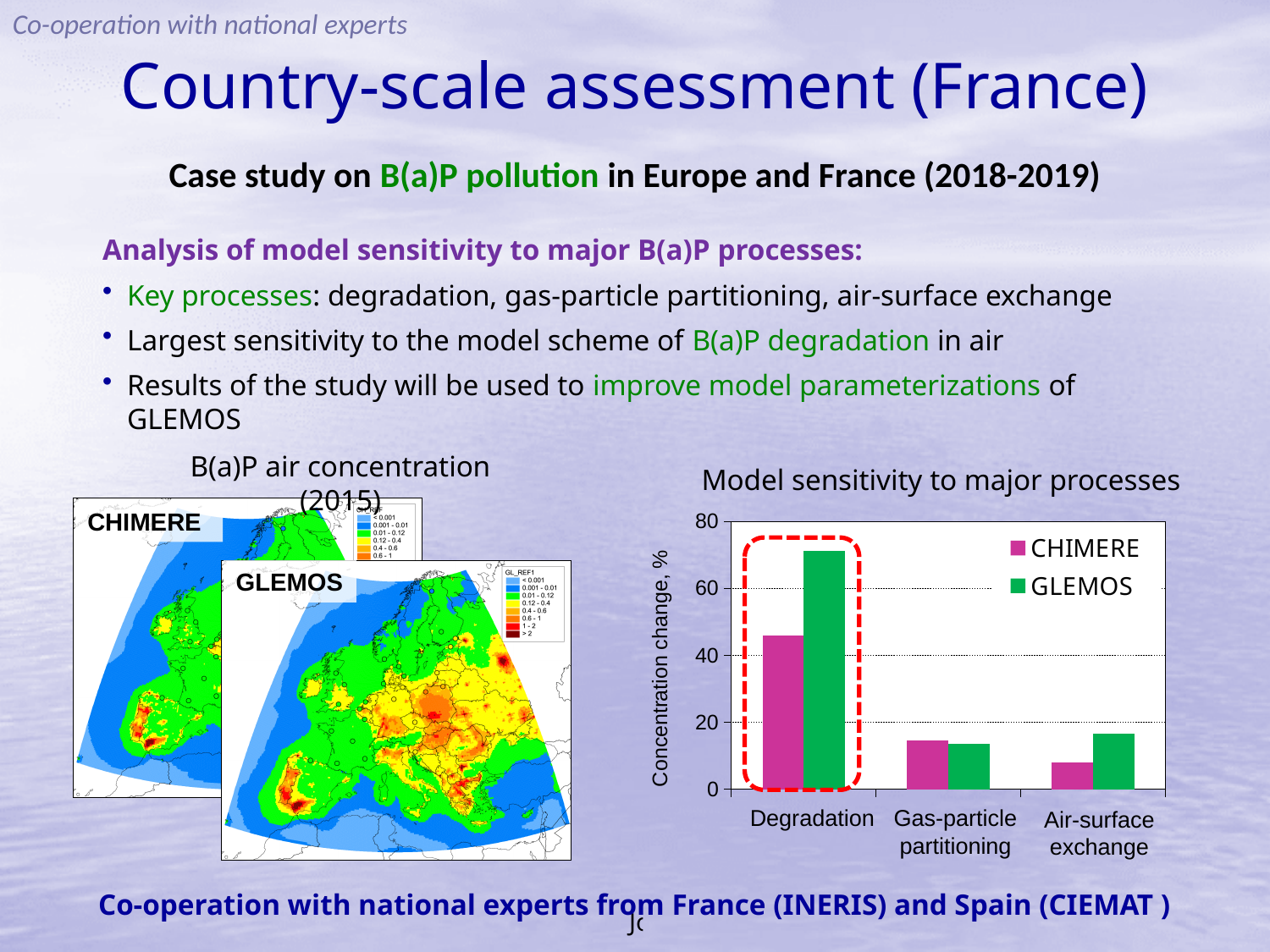
In the 'Model sensitivity to major processes' chart, which process has the highest CHIMERE value? Degradation How many process categories are shown on the x axis of the 'Model sensitivity to major processes' chart? 3 How many series does the legend of the 'Model sensitivity to major processes' chart list? 2 What kind of chart is 'Model sensitivity to major processes'? bar chart In the 'Model sensitivity to major processes' chart, which series has the larger value for Degradation, CHIMERE or GLEMOS? GLEMOS In the 'Model sensitivity to major processes' chart, which series has the larger value for Air-surface exchange, CHIMERE or GLEMOS? GLEMOS In the 'Model sensitivity to major processes' chart, is the GLEMOS value for Degradation greater or less than 60? greater In the 'Model sensitivity to major processes' chart, which process has the highest GLEMOS value? Degradation In the 'Model sensitivity to major processes' chart, is the CHIMERE value for Air-surface exchange greater or less than 20? less In the 'Model sensitivity to major processes' chart, is the CHIMERE value for Degradation greater or less than 40? greater In the 'Model sensitivity to major processes' chart, which process has the lowest CHIMERE value? Air-surface exchange What is the y-axis label of the 'Model sensitivity to major processes' chart? Concentration change, %